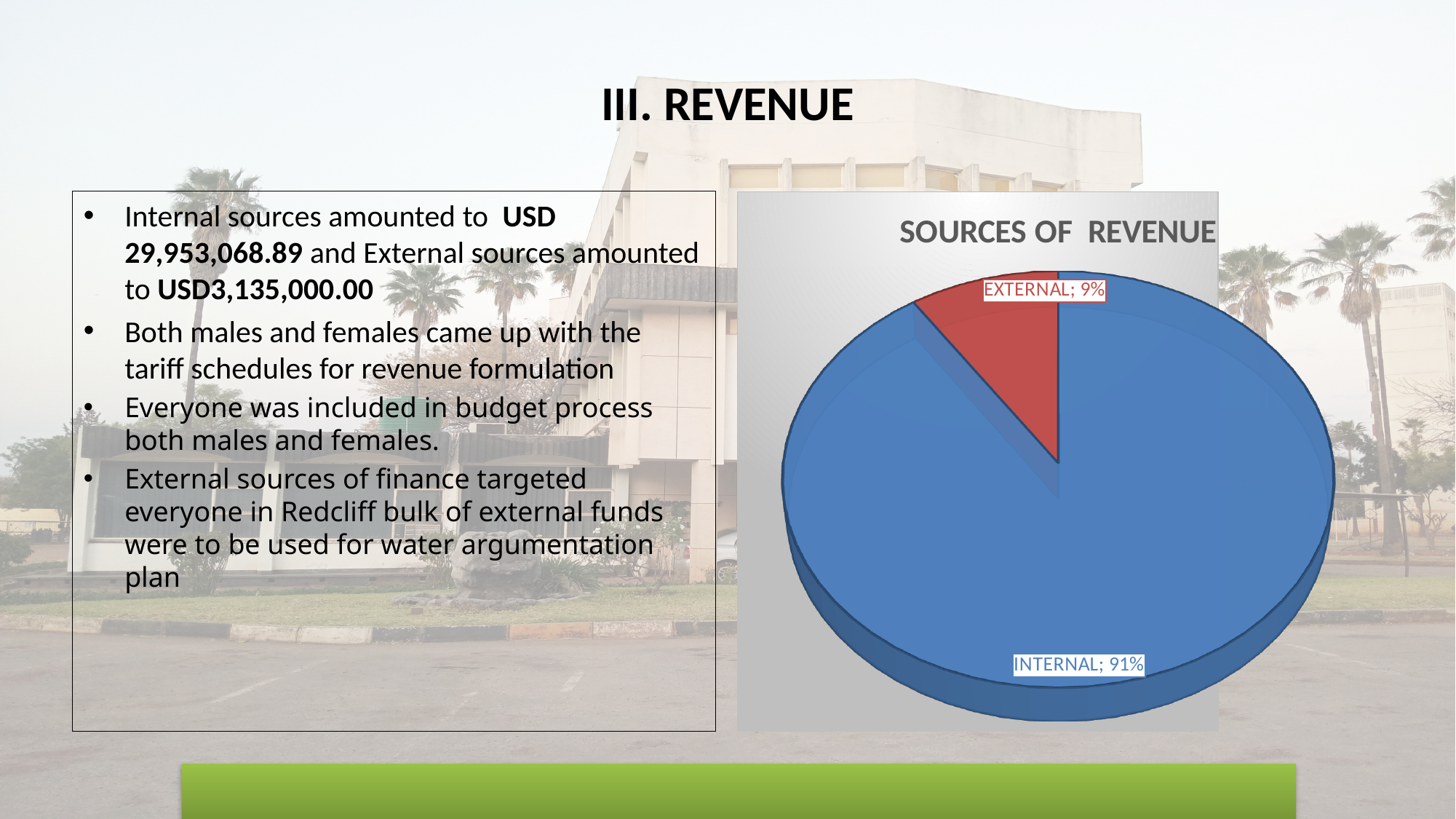
Which source of revenue has the largest share? INTERNAL What is the difference in percentage points between the INTERNAL and EXTERNAL shares? 82 Which is larger, the INTERNAL share or the EXTERNAL share? INTERNAL What type of chart is shown on the slide? Pie chart Which source of revenue has the smallest share? EXTERNAL What is the title of the chart? SOURCES OF REVENUE How many slices does the pie chart have? 2 What colour is the INTERNAL slice of the pie chart? Blue What share of revenue comes from EXTERNAL sources? 9% What share of revenue comes from INTERNAL sources? 91%